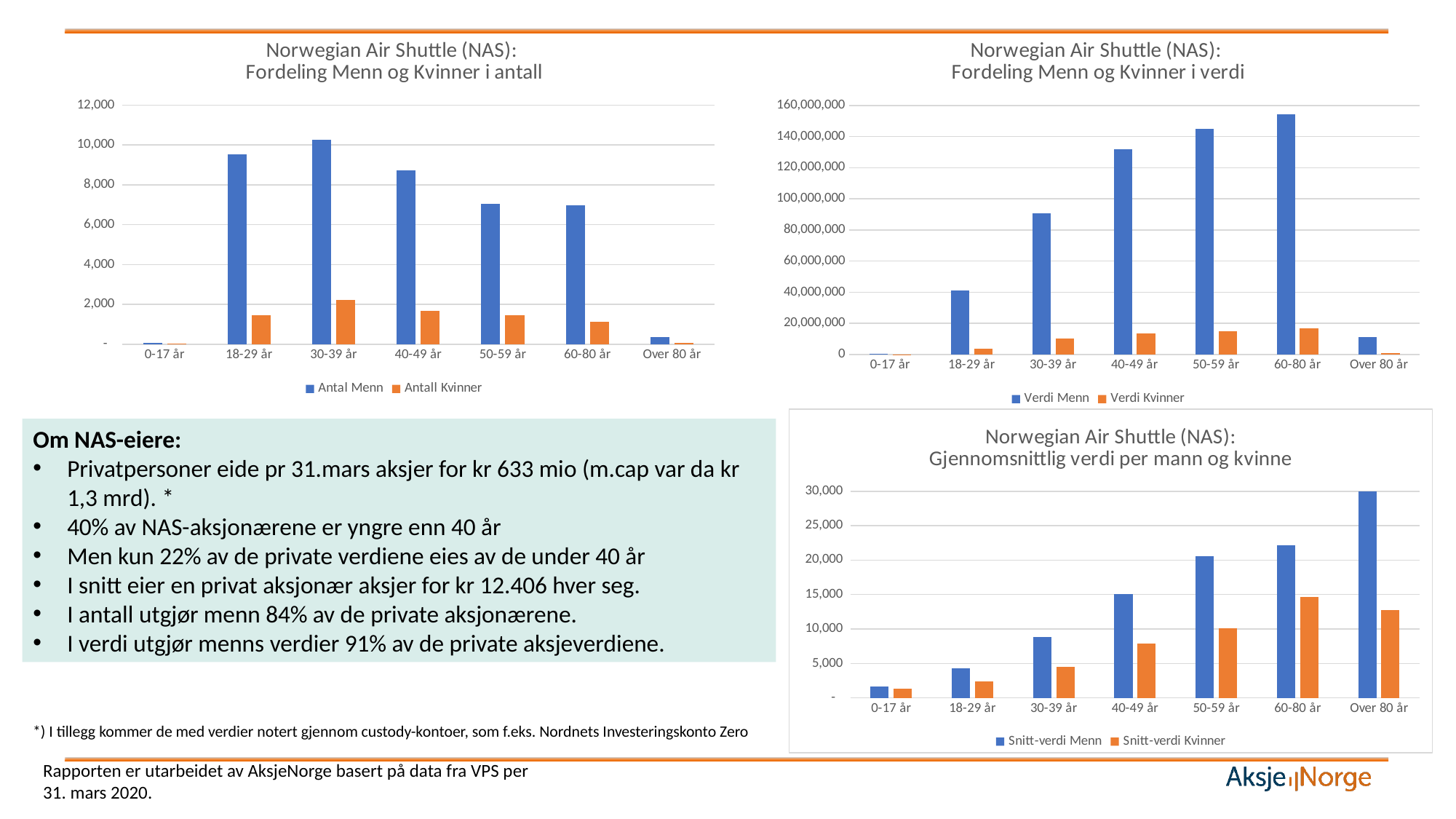
In the chart 'Fordeling Menn og Kvinner i verdi', which age group has the highest value for Verdi Menn? 60-80 år In the chart 'Fordeling Menn og Kvinner i verdi', is the value for Verdi Menn in the 30-39 år group greater or less than 80,000,000? greater In the chart 'Fordeling Menn og Kvinner i antall', which age group has the highest value for Antal Menn? 30-39 år In the chart 'Gjennomsnittlig verdi per mann og kvinne', is the value for Snitt-verdi Kvinner in the 40-49 år group greater or less than 10,000? less What kind of chart is 'Gjennomsnittlig verdi per mann og kvinne'? bar chart In the chart 'Fordeling Menn og Kvinner i antall', is the value for Antal Menn in the 18-29 år group greater or less than 8,000? greater In the chart 'Gjennomsnittlig verdi per mann og kvinne', which age group has the highest value for Snitt-verdi Menn? Over 80 år In the chart 'Fordeling Menn og Kvinner i verdi', how many series does the legend list? 2 In the chart 'Fordeling Menn og Kvinner i antall', how many age groups are shown on the x axis? 7 In the chart 'Fordeling Menn og Kvinner i antall', which age group has the lowest value for Antal Menn? 0-17 år In the chart 'Gjennomsnittlig verdi per mann og kvinne', do the values for Snitt-verdi Menn rise or fall from 0-17 år to Over 80 år? rise In the chart 'Fordeling Menn og Kvinner i verdi', which is larger for Verdi Menn: 40-49 år or 50-59 år? 50-59 år